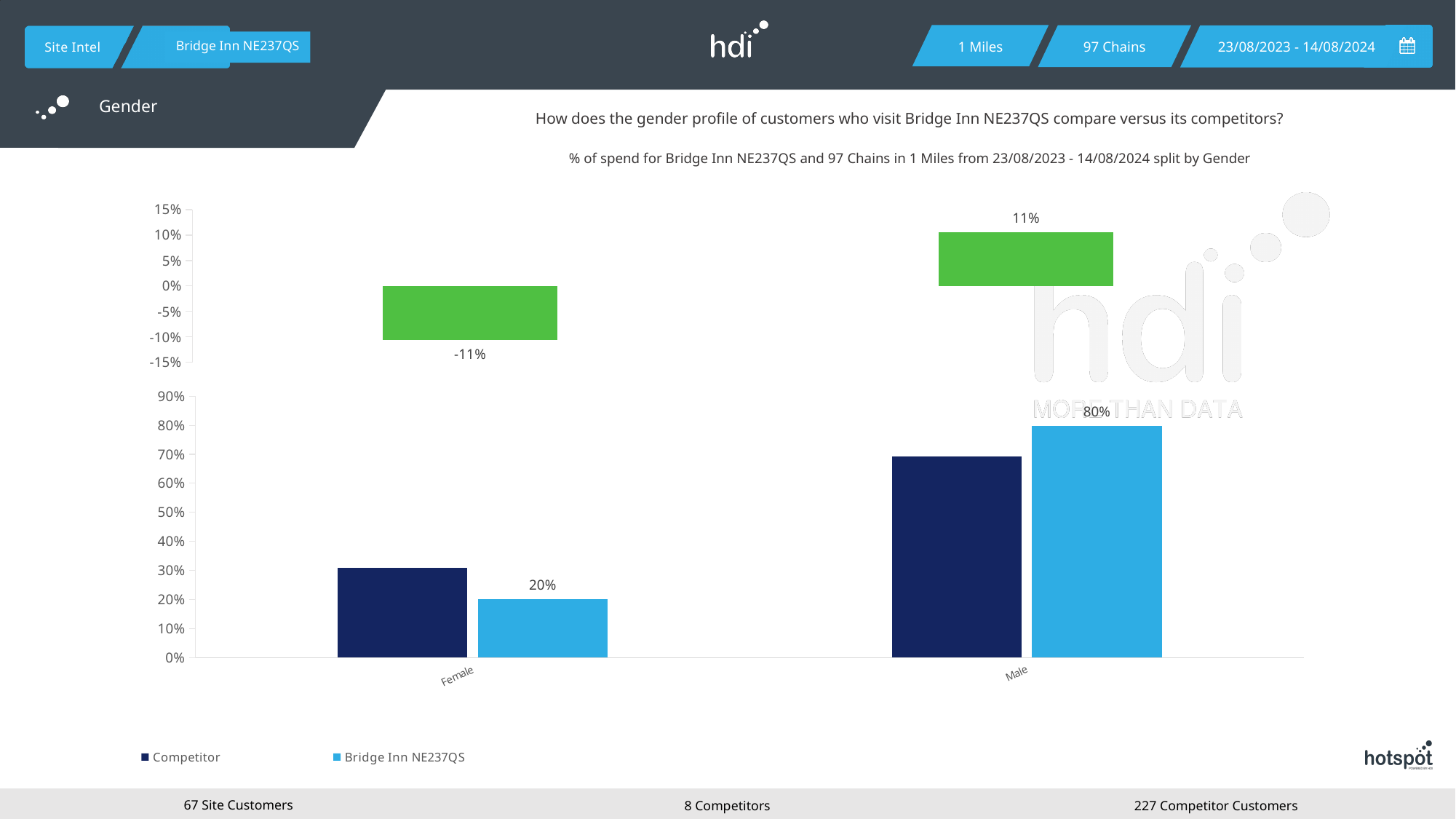
How many categories are shown on the x axis of the bottom bar chart? 2 In the bottom bar chart, what is the difference between the Bridge Inn NE237QS values for Male and Female? 60% In the bottom bar chart, which is larger for Female: Competitor or Bridge Inn NE237QS? Competitor In the bottom bar chart, what is the value for Bridge Inn NE237QS for Male? 80% In the bottom bar chart, what is the value for Bridge Inn NE237QS for Female? 20% In the top chart, what is the value shown for Male? 11% In the bottom bar chart, which is larger for Male: Competitor or Bridge Inn NE237QS? Bridge Inn NE237QS In the bottom bar chart, is the Competitor value for Female greater or less than 40%? less What kind of chart is the bottom chart? Bar chart In the top chart, what is the value shown for Female? -11% In the bottom bar chart, is the Competitor value for Male greater or less than 60%? greater How many series does the legend of the bottom bar chart list? 2